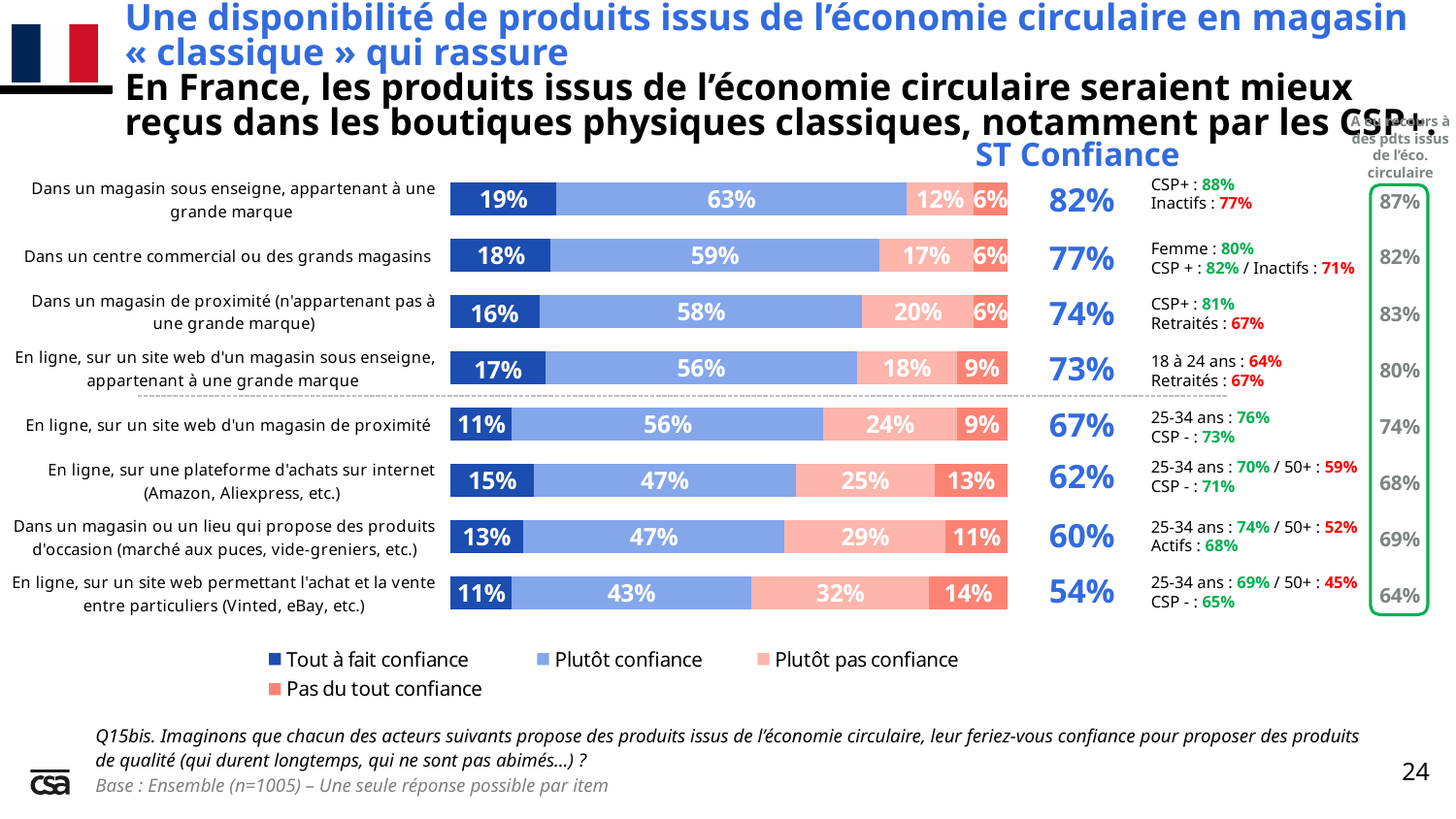
What is the ST Confiance value for 'Dans un centre commercial ou des grands magasins'? 77% What is the 'Tout à fait confiance' value for 'Dans un magasin sous enseigne, appartenant à une grande marque'? 19% How many series does the legend list? 4 What kind of chart is shown on the slide? Stacked bar chart What is the total of 'Tout à fait confiance' and 'Plutôt confiance' for 'Dans un magasin de proximité (n'appartenant pas à une grande marque)'? 74% Which is larger: the 'Pas du tout confiance' value for 'En ligne, sur une plateforme d'achats sur internet (Amazon, Aliexpress, etc.)' or for 'Dans un magasin ou un lieu qui propose des produits d'occasion (marché aux puces, vide-greniers, etc.)'? En ligne, sur une plateforme d'achats sur internet (Amazon, Aliexpress, etc.) What is the difference between the ST Confiance values for 'Dans un magasin sous enseigne, appartenant à une grande marque' and 'En ligne, sur un site web permettant l'achat et la vente entre particuliers (Vinted, eBay, etc.)'? 28 percentage points What is the 'Plutôt pas confiance' value for 'En ligne, sur un site web permettant l'achat et la vente entre particuliers (Vinted, eBay, etc.)'? 32% Do the ST Confiance values rise or fall going from the top category to the bottom category? Fall Which category has the lowest 'Plutôt confiance' value? En ligne, sur un site web permettant l'achat et la vente entre particuliers (Vinted, eBay, etc.) How many categories (types of sellers) are plotted in the chart? 8 Which category has the highest ST Confiance value? Dans un magasin sous enseigne, appartenant à une grande marque